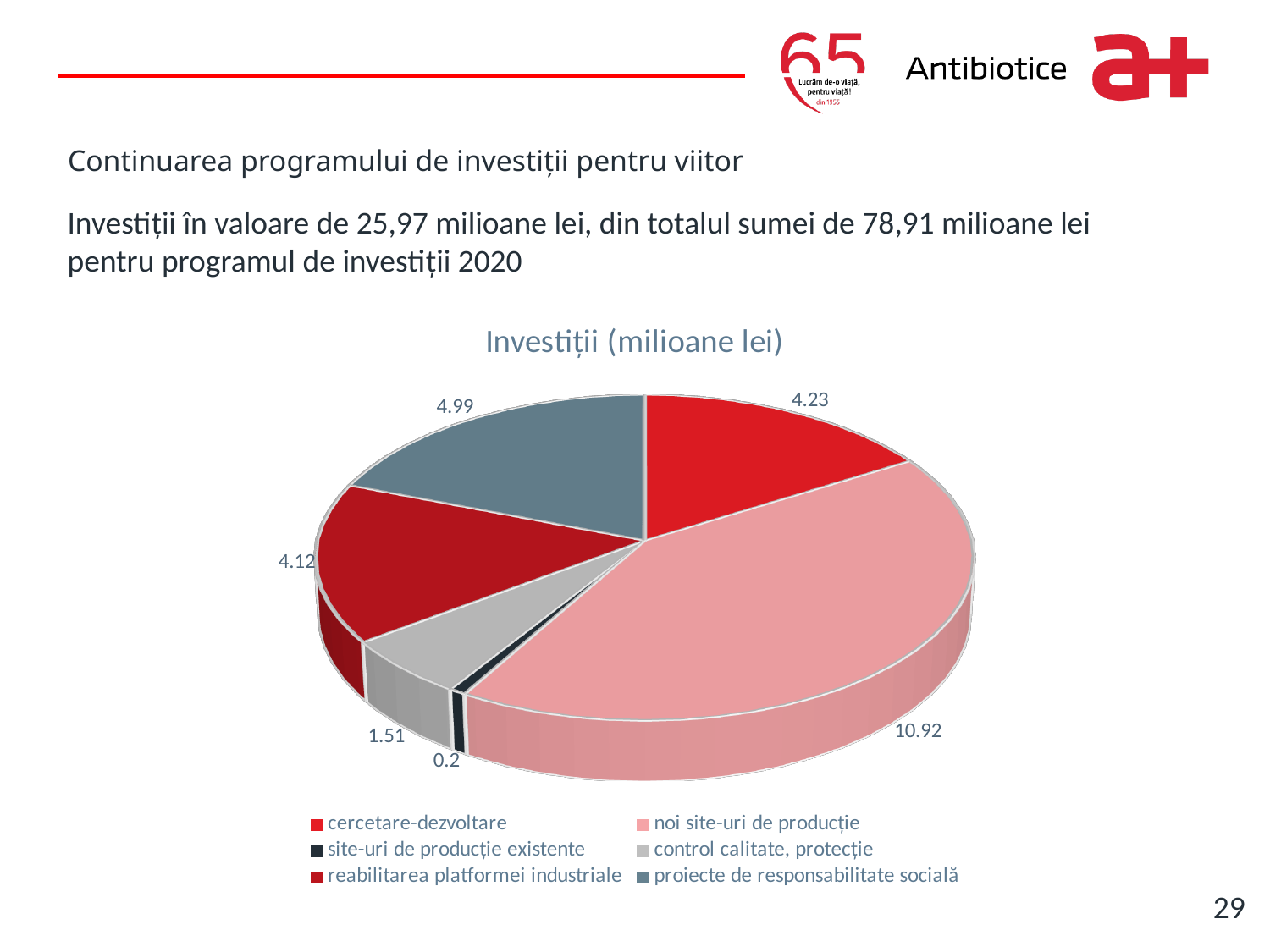
What is the difference between the values for 'noi site-uri de producție' and 'proiecte de responsabilitate socială'? 5.93 What is the value for 'cercetare-dezvoltare'? 4.23 What is the value for 'site-uri de producție existente'? 0.2 What is the value for 'noi site-uri de producție'? 10.92 Which is larger: 'control calitate, protecție' or 'reabilitarea platformei industriale'? reabilitarea platformei industriale Which category has the smallest slice? site-uri de producție existente How many entries does the legend list? 6 What type of chart is shown on the slide? pie chart How many slices does the pie chart have? 6 What is the value for 'proiecte de responsabilitate socială'? 4.99 What is the title of the chart? Investiții (milioane lei) Which category has the largest slice? noi site-uri de producție